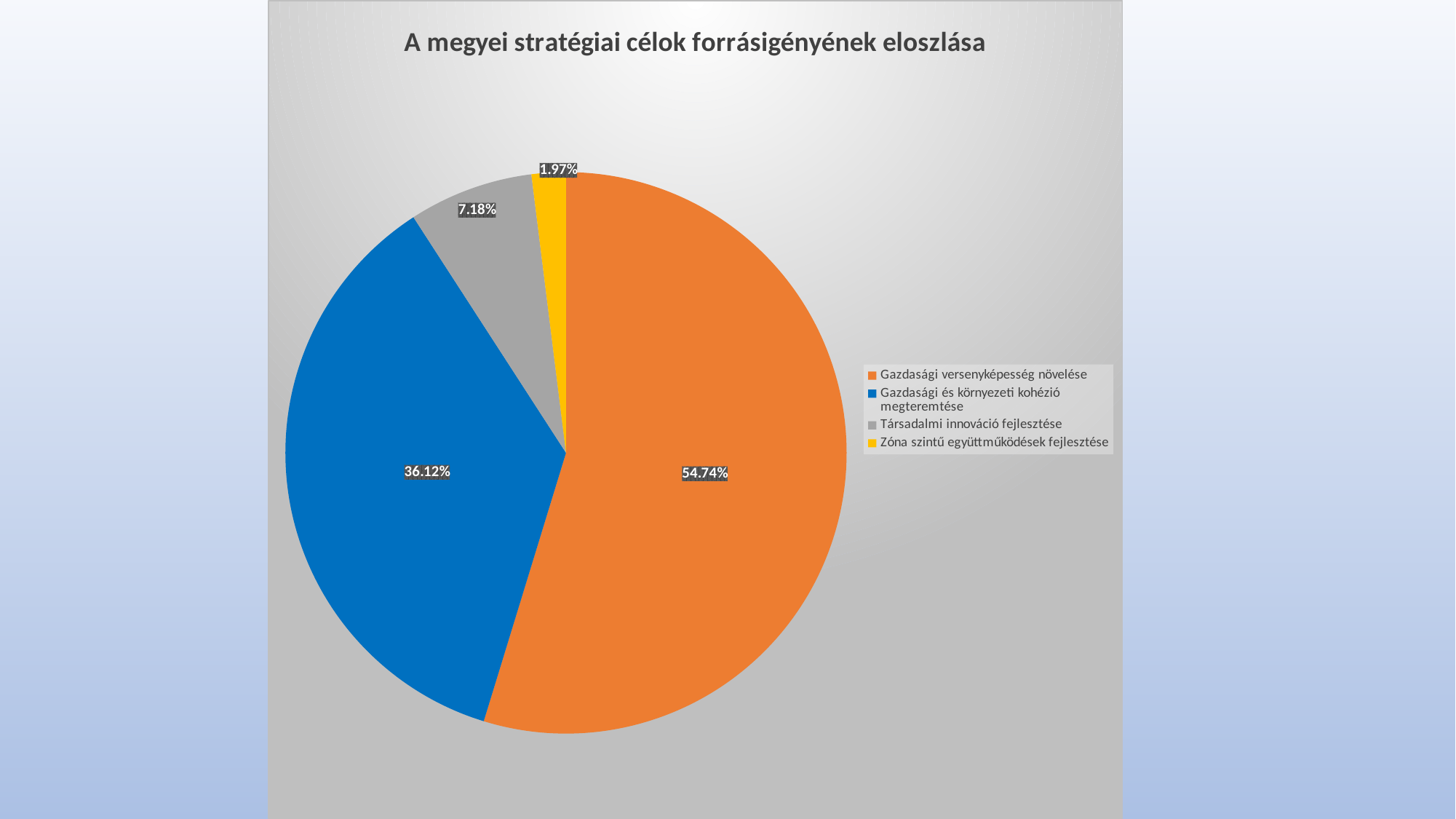
What colour is the slice for 'Gazdasági és környezeti kohézió megteremtése'? Blue What share of the pie does 'Társadalmi innováció fejlesztése' have? 7.18% Which category has the smallest slice of the pie? Zóna szintű együttműködések fejlesztése What is the title of the chart? A megyei stratégiai célok forrásigényének eloszlása What kind of chart is shown on the slide? Pie chart What is the difference in percentage points between 'Gazdasági versenyképesség növelése' and 'Gazdasági és környezeti kohézió megteremtése'? 18.62 What share of the pie does 'Gazdasági versenyképesség növelése' have? 54.74% Which is larger: the slice for 'Társadalmi innováció fejlesztése' or the slice for 'Zóna szintű együttműködések fejlesztése'? Társadalmi innováció fejlesztése Which category has the largest slice of the pie? Gazdasági versenyképesség növelése What share of the pie does 'Zóna szintű együttműködések fejlesztése' have? 1.97% How many slices does the pie chart have? 4